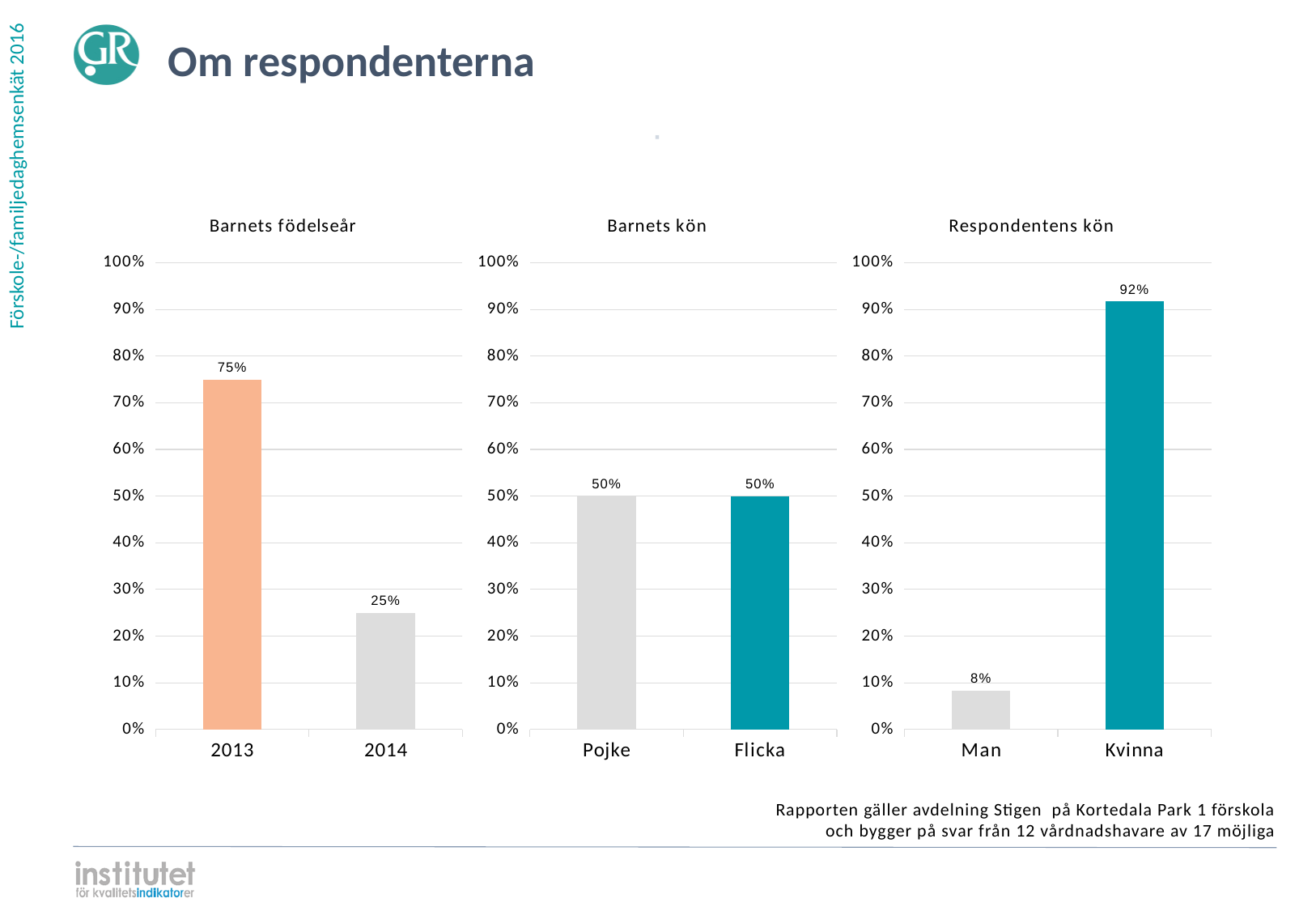
In the 'Barnets födelseår' chart, what is the value for 2014? 25% In the 'Respondentens kön' chart, what is the value for Kvinna? 92% In the 'Respondentens kön' chart, which category has the highest value? Kvinna In the 'Respondentens kön' chart, what is the value for Man? 8% In the 'Barnets kön' chart, what is the value for Pojke? 50% In the 'Barnets kön' chart, what is the value for Flicka? 50% How many categories are shown in the 'Barnets kön' chart? 2 In the 'Respondentens kön' chart, what is the difference between the values for Kvinna and Man? 84% What kind of chart is the 'Respondentens kön' chart? Bar chart In the 'Barnets födelseår' chart, what is the value for 2013? 75% In the 'Barnets födelseår' chart, which is larger, the value for 2013 or 2014? 2013 In the 'Barnets födelseår' chart, what is the difference between the values for 2013 and 2014? 50%